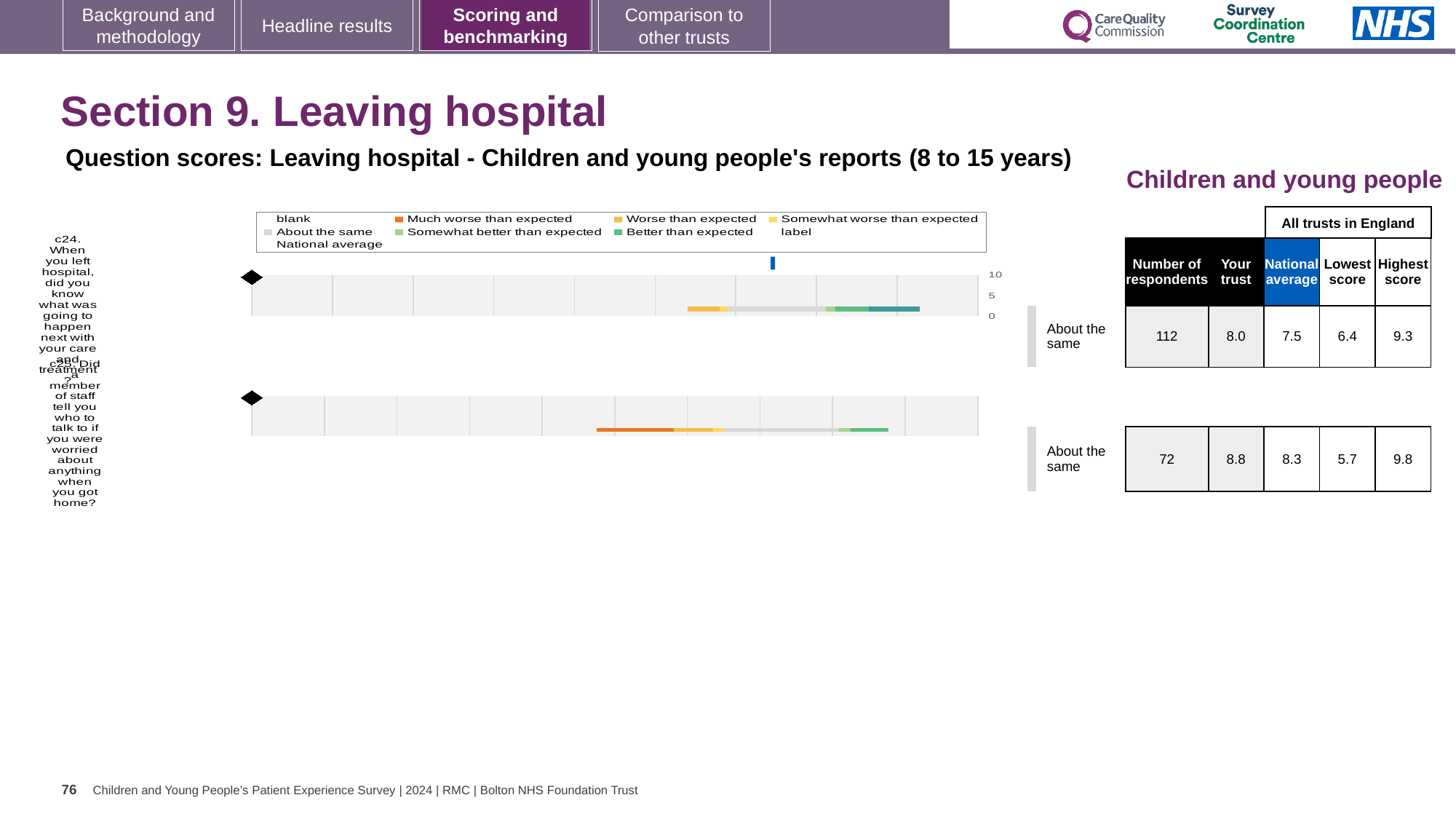
What is the lowest score across all trusts in England for question c24? 6.4 What benchmark category is shown for both questions c24 and c25? About the same What is the national average score for question c25 (Did a member of staff tell you who to talk to if you were worried about anything when you got home?)? 8.3 What colour in the legend represents 'Much worse than expected'? orange What is the highest score across all trusts in England for question c25? 9.8 What is the 'Your trust' score for question c24 (When you left hospital, did you know what was going to happen next with your care and treatment?)? 8.0 What kind of chart is used to show the question scores on this slide? bar chart Which question has the higher 'Your trust' score, c24 or c25? c25 What is the difference between the 'Your trust' score and the national average for question c24? 0.5 How many respondents answered question c24? 112 For question c25, is the 'Your trust' score higher or lower than the national average? higher How many survey questions are plotted on the slide? 2